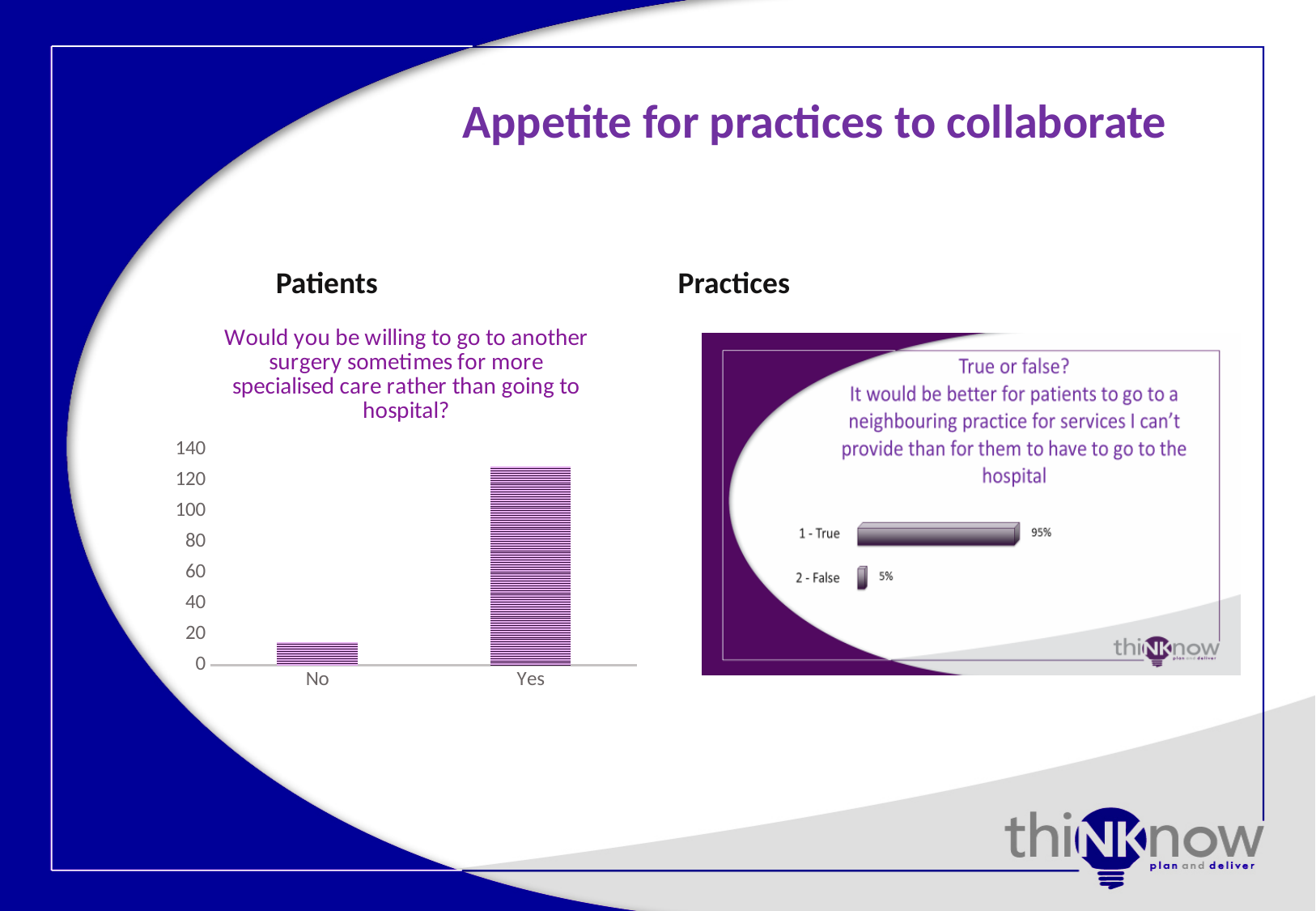
On the Practices chart, what percentage answered False? 5% On the Patients chart, is the value for No greater or less than 20? less What kind of chart is the Patients chart? bar chart On the Practices chart, which response has the highest value? 1 - True On the Practices chart, what percentage answered True? 95% On the Patients chart, which category has the lowest value? No How many categories are shown on the Patients chart? 2 On the Practices chart, what is the difference between the True and False percentages? 90% What is the question shown as the title of the Patients chart? Would you be willing to go to another surgery sometimes for more specialised care rather than going to hospital? On the Patients chart, which category has the highest value? Yes On the Patients chart, is the value for Yes greater or less than 120? greater On the Patients chart, which is larger, the value for No or the value for Yes? Yes